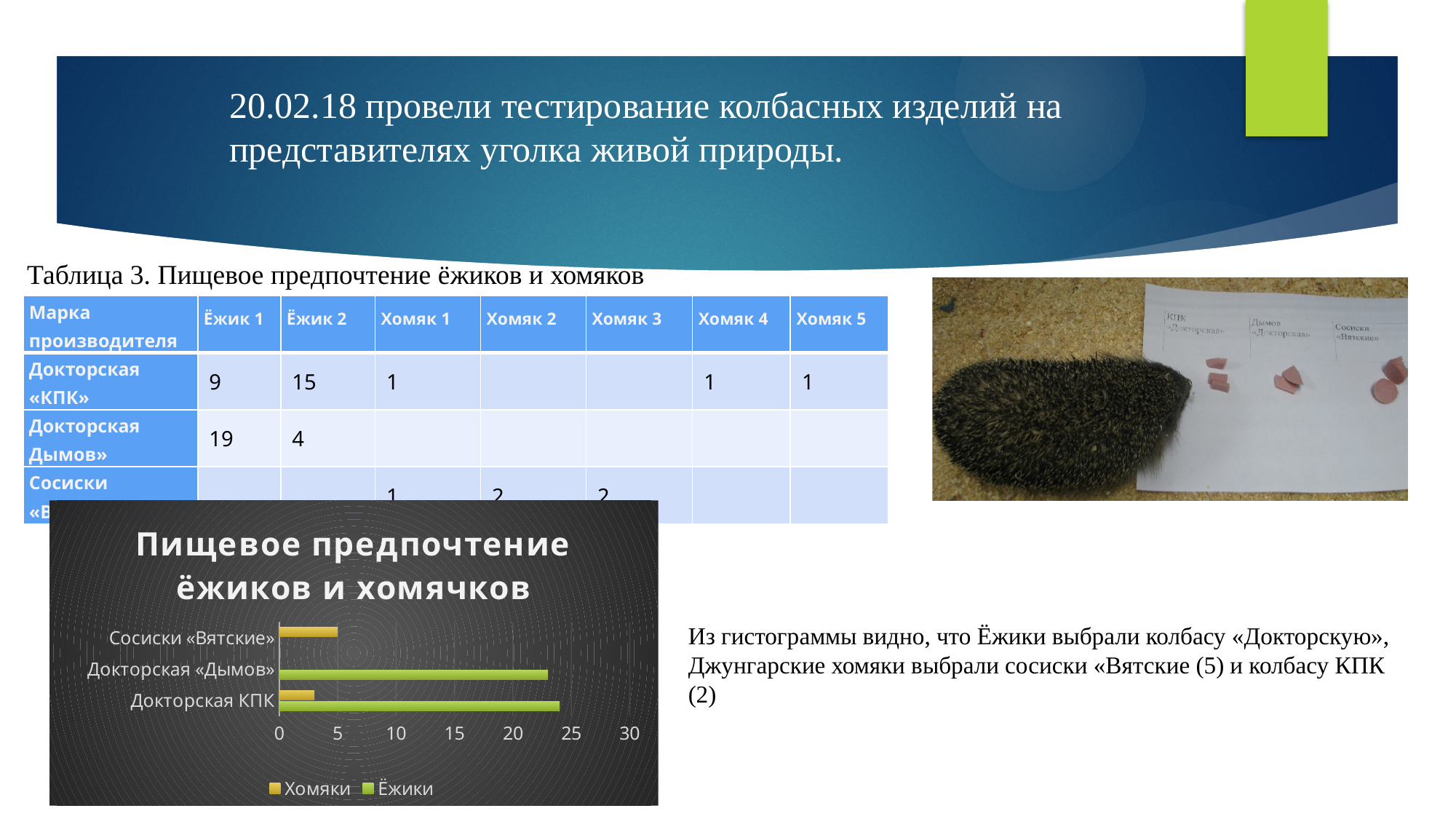
What is the title of the chart on the slide? Пищевое предпочтение ёжиков и хомячков How many categories are shown on the chart's vertical axis? 3 Is the Хомяки value for Сосиски «Вятские» greater or less than 10? less Is the Ёжики value for Докторская «Дымов» greater or less than 20? greater Which series is shown in green in the chart? Ёжики How many series does the chart legend list? 2 Is the Ёжики value for Докторская КПК greater or less than 20? greater For the Хомяки series, which is larger: Сосиски «Вятские» or Докторская КПК? Сосиски «Вятские» What kind of chart is shown on the slide? bar chart Which category has the highest Хомяки value in the chart? Сосиски «Вятские»